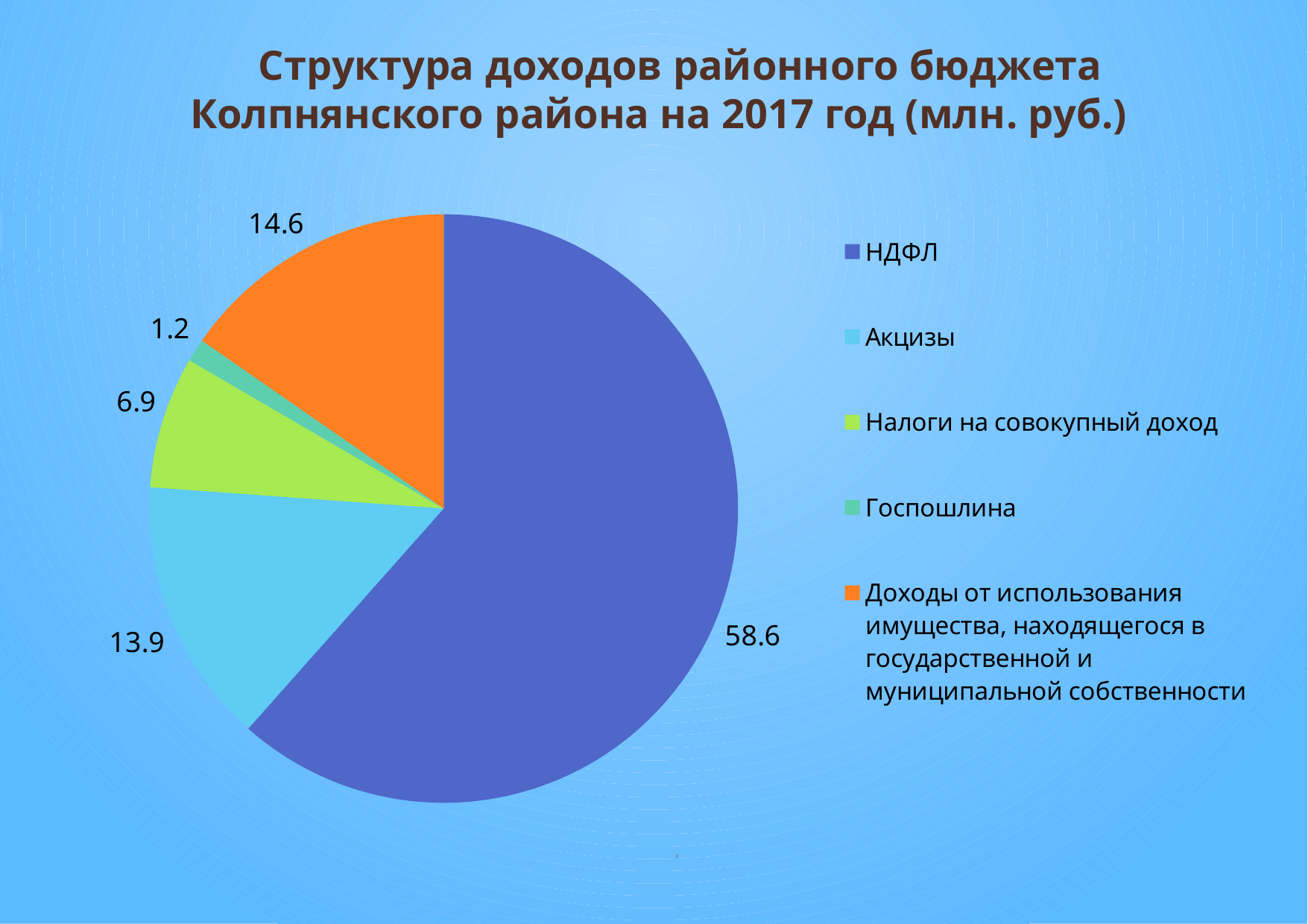
Which category has the largest slice of the pie? НДФЛ What type of chart is shown on the slide? Pie chart What is the value for Акцизы? 13.9 What is the value for НДФЛ? 58.6 Which is larger: the value for Акцизы or the value for Налоги на совокупный доход? Акцизы What is the value for Доходы от использования имущества, находящегося в государственной и муниципальной собственности? 14.6 What is the value for Налоги на совокупный доход? 6.9 What is the difference between the values for НДФЛ and Акцизы? 44.7 What is the value for Госпошлина? 1.2 How many categories does the pie chart show? 5 Which category has the smallest slice of the pie? Госпошлина What colour is the slice for Госпошлина? Teal (green-blue)